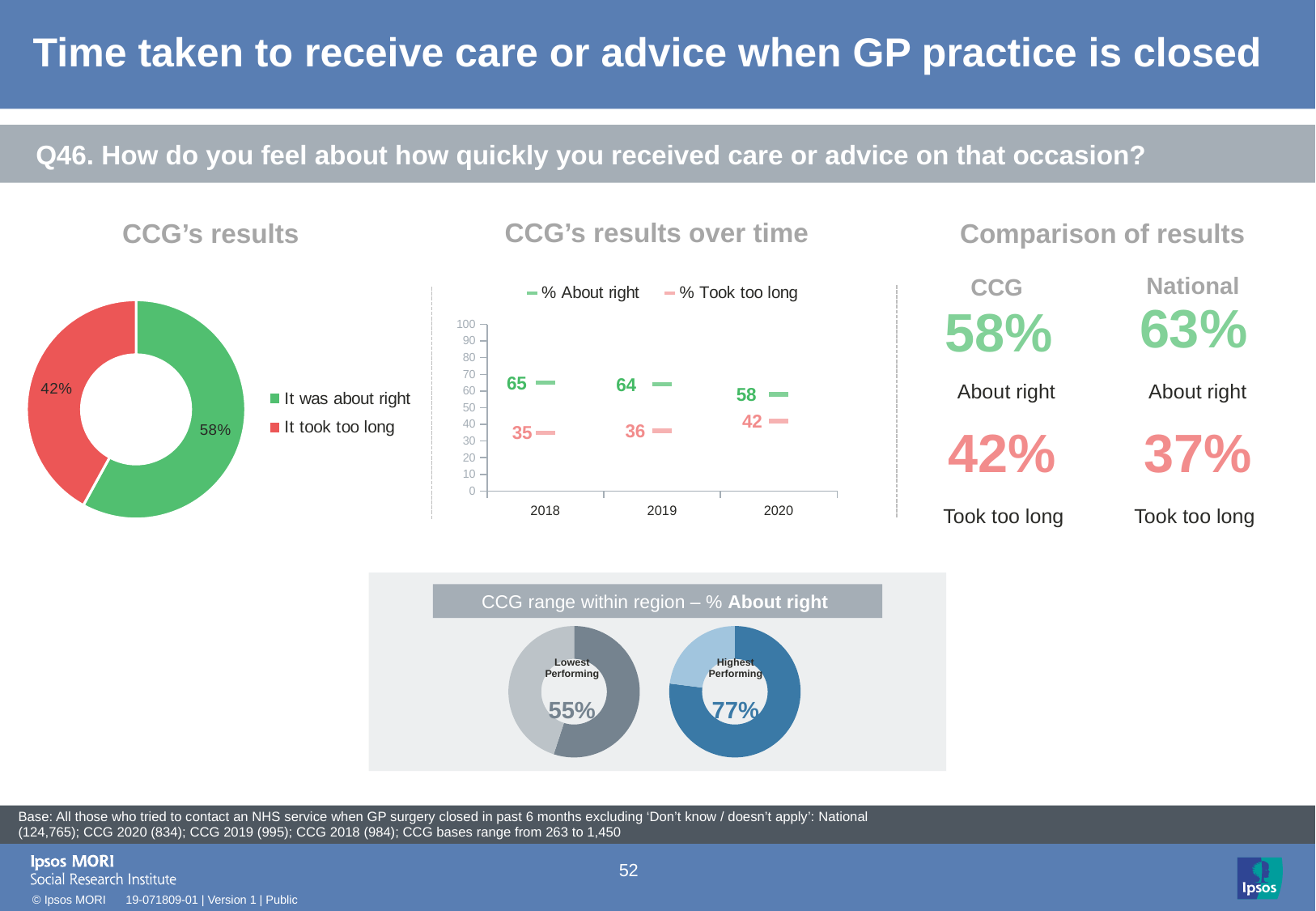
In the 'CCG's results' doughnut chart, what percentage is shown for 'It was about right'? 58% In the 'CCG's results' doughnut chart, what percentage is shown for 'It took too long'? 42% In the 'CCG's results over time' chart, what is the value for '% About right' in 2018? 65 In the 'CCG's results over time' chart, is the 2018 value for '% About right' greater or less than 60? greater In the 'CCG's results over time' chart, what is the difference between '% About right' and '% Took too long' in 2019? 28 In the 'CCG's results over time' chart, which year has the lowest value for '% About right'? 2020 In the 'CCG's results over time' chart, which year has the highest value for '% Took too long'? 2020 What kind of chart is the 'CCG's results' chart? Doughnut chart In the 'CCG's results over time' chart, what is the value for '% Took too long' in 2020? 42 How many years are plotted on the x axis of the 'CCG's results over time' chart? 3 In the 'CCG's results over time' chart, does '% About right' rise or fall from 2018 to 2020? Fall How many series does the legend of the 'CCG's results over time' chart list? 2